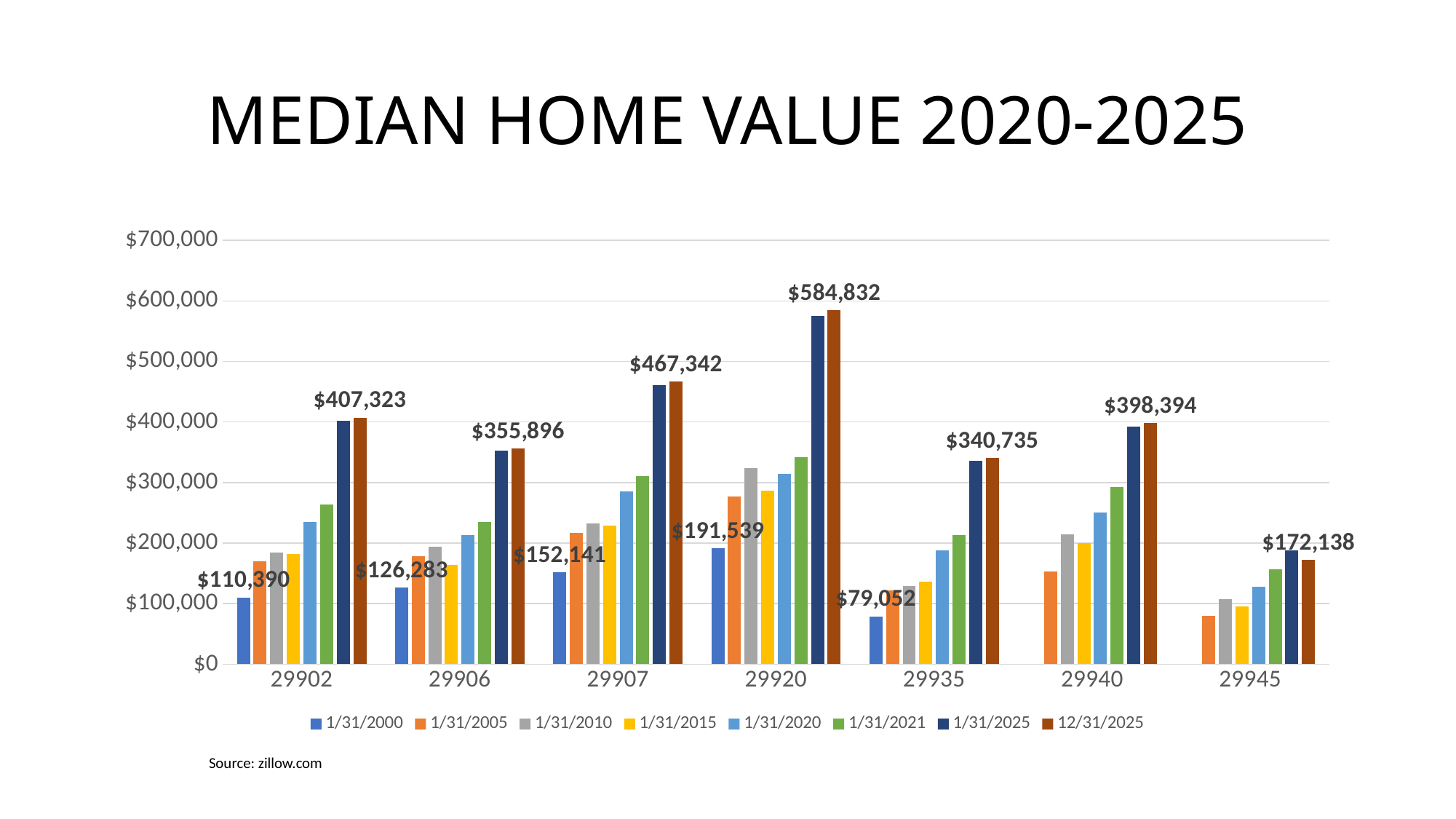
Which has the larger 12/31/2025 median home value, 29902 or 29940? 29902 What is the 12/31/2025 median home value for zip code 29945? $172,138 How many zip codes are shown on the x axis? 7 What is the difference between the 1/31/2000 median home values for 29920 and 29902? $81,149 How many series does the legend list? 8 What is the 1/31/2000 median home value for zip code 29935? $79,052 Which zip code has the highest 12/31/2025 median home value? 29920 What is the 12/31/2025 median home value for zip code 29920? $584,832 Is the 1/31/2021 median home value for 29920 greater or less than $300,000? greater What type of chart is shown on the slide? bar chart What is the difference between the 12/31/2025 median home values for 29907 and 29906? $111,446 Which zip code has the lowest 12/31/2025 median home value? 29945